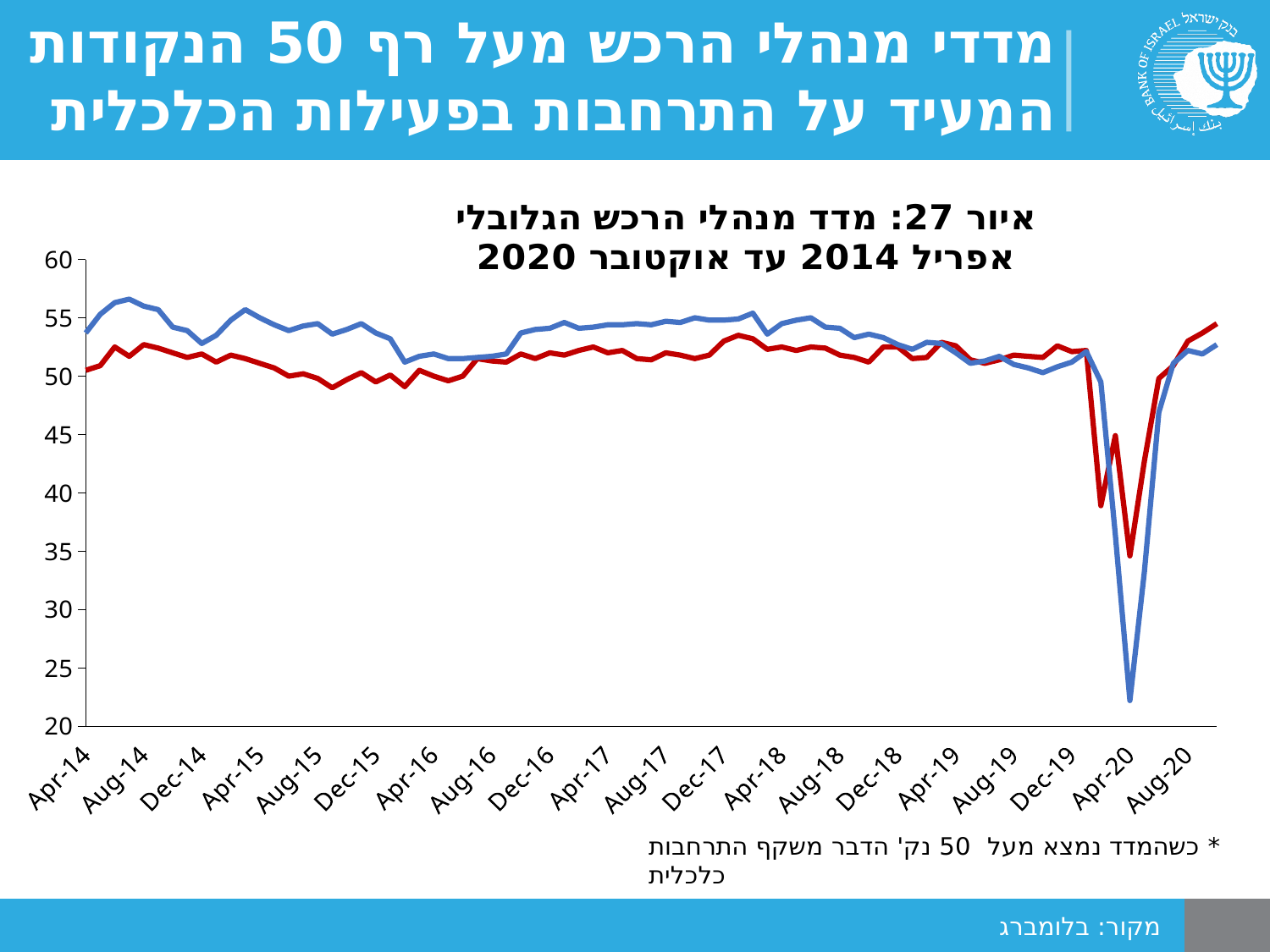
What is the title of the chart? איור 27: מדד מנהלי הרכש הגלובלי אפריל 2014 עד אוקטובר 2020 Which line falls to a lower value around Apr-20, the blue line or the red line? the blue line Is the value of the red line at Aug-14 greater or less than 55? less Is the lowest value of the red line greater or less than 40? less How many lines are plotted on the chart? 2 What is the first x-axis label on the chart? Apr-14 Is the value of the blue line at Aug-14 greater or less than 55? greater What kind of chart is shown on the slide? line chart Around Apr-20, do the lines rise or fall sharply? fall